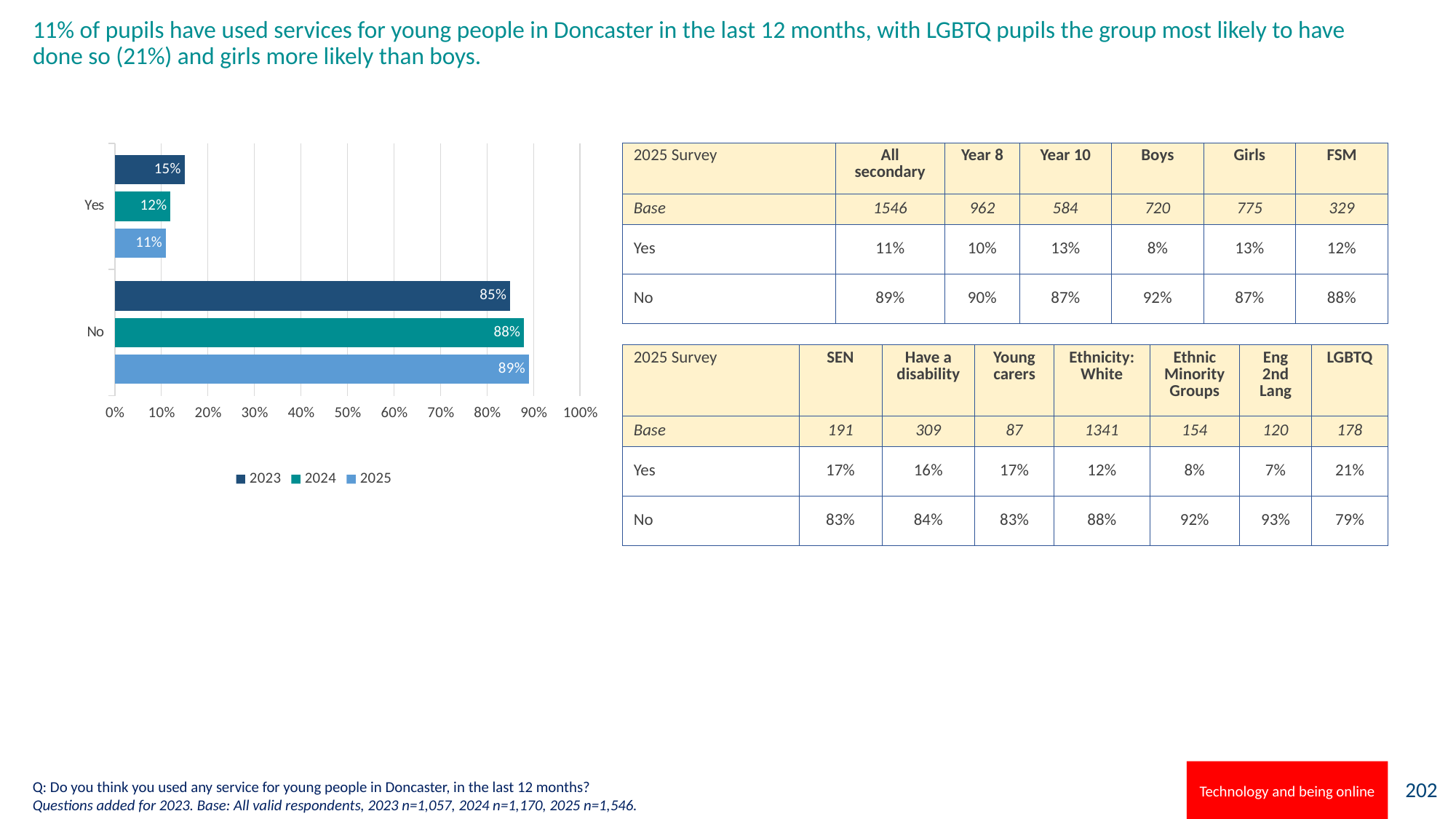
Which is larger: the 2024 value for 'No' or the 2025 value for 'No'? 2025 Which series is shown in teal/green in the legend? 2024 What is the value for 'No' in the 2023 series? 85% Is the 2025 value for 'No' greater or less than 80%? greater Which year has the highest value for 'Yes'? 2023 What is the difference between the 2023 and 2025 values for 'Yes'? 4% What is the value for 'Yes' in the 2024 series? 12% How many series does the legend list? 3 What kind of chart is shown on the slide? Bar chart How many categories are shown on the chart? 2 What is the value for 'Yes' in the 2025 series? 11% Which year has the lowest value for 'No'? 2023